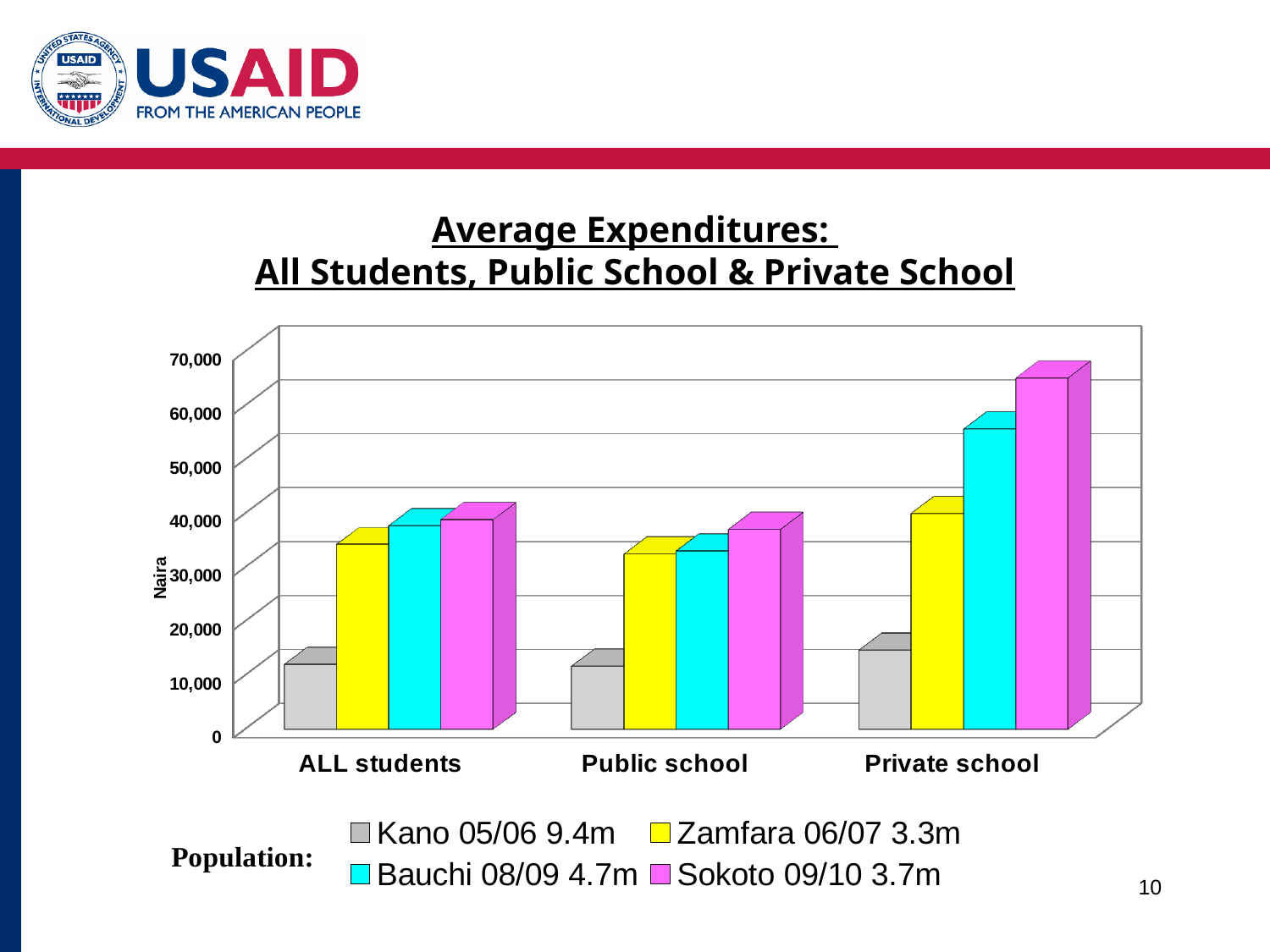
Which series has the highest value in the Private school category? Sokoto 09/10 3.7m In which category is the value for Sokoto 09/10 3.7m highest? Private school What kind of chart is shown on the slide? bar chart What is the label on the vertical axis of the chart? Naira Is the value for Bauchi 08/09 4.7m in the Private school category greater or less than 50,000? greater Is the value for Sokoto 09/10 3.7m in the Private school category greater or less than 60,000? greater Which series has the lowest value in the Private school category? Kano 05/06 9.4m How many categories are shown on the x axis of the chart? 3 Which is larger for Bauchi 08/09 4.7m: the Public school value or the Private school value? Private school Which series has the lowest value in the Public school category? Kano 05/06 9.4m Is the value for Kano 05/06 9.4m in the ALL students category greater or less than 20,000? less How many series does the chart's legend list? 4